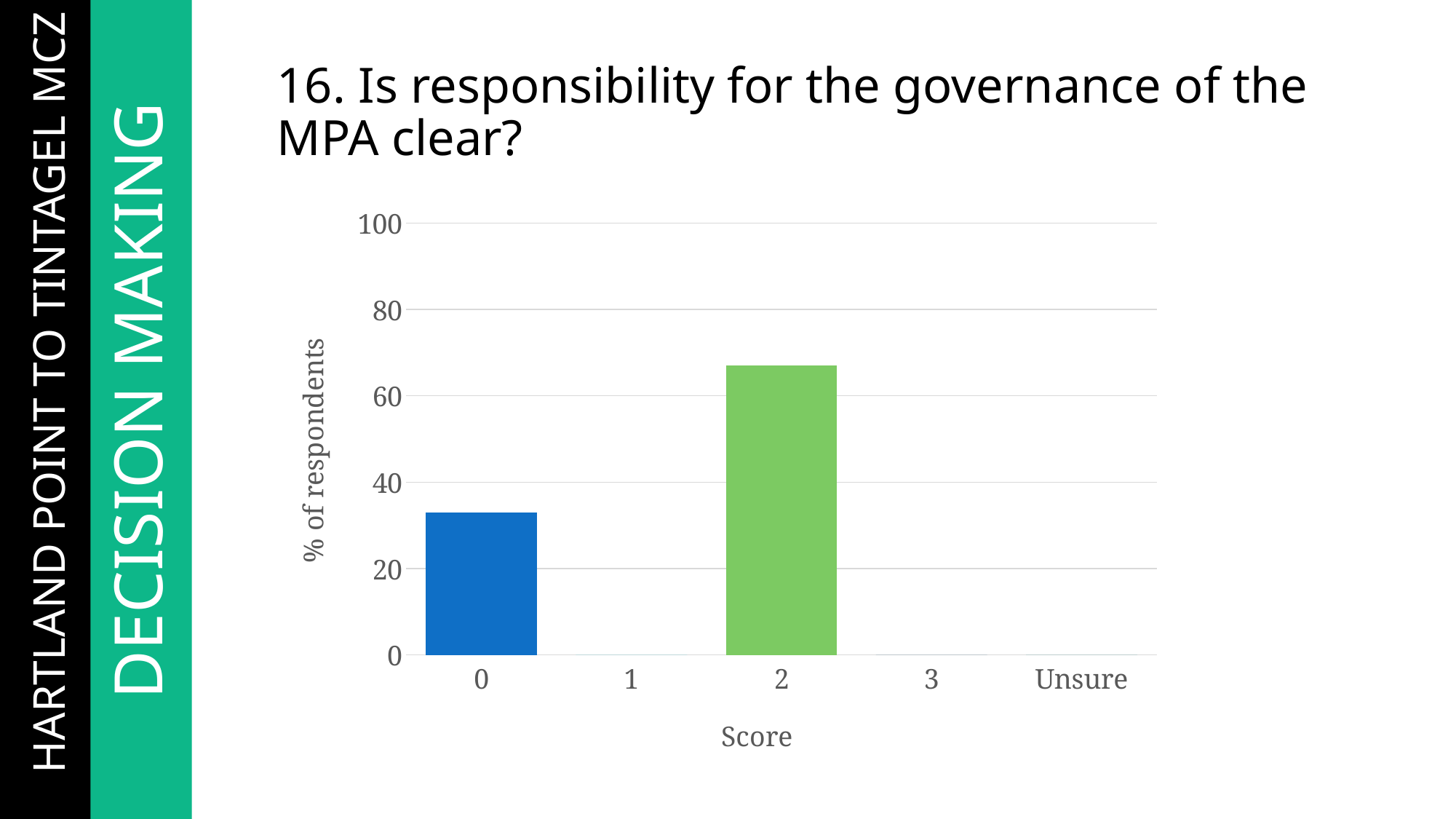
Is the value for score 0 greater or less than 20? greater Is the value for score 2 greater or less than 80? less Which score category has the highest percentage of respondents? 2 How many score categories are shown on the x axis? 5 What kind of chart is shown on the slide? bar chart What is the label of the x axis? Score Is the value for score 2 greater or less than 60? greater What is the label of the y axis? % of respondents Which has a larger percentage of respondents, score 0 or score 2? 2